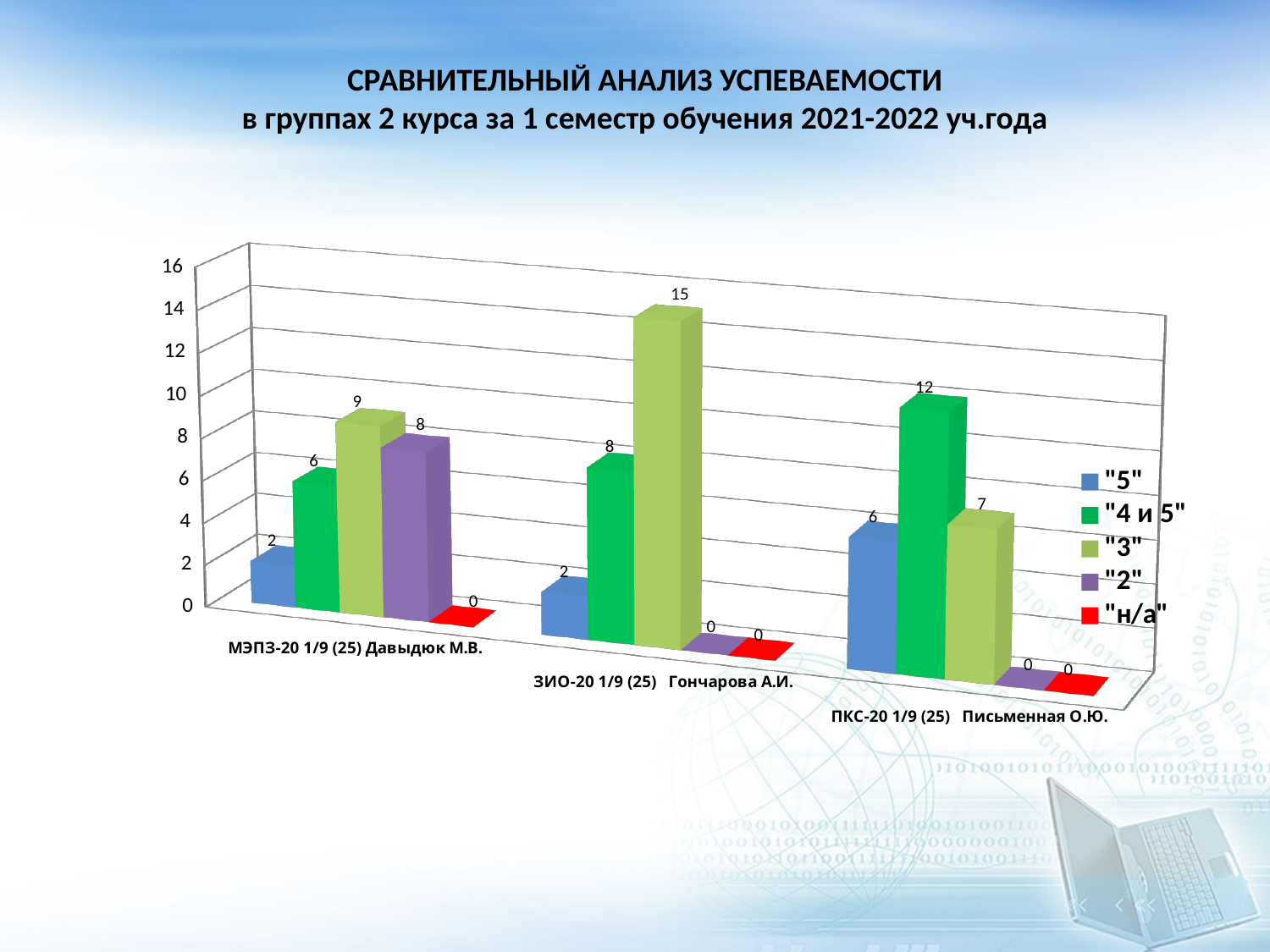
What is the value of the "4 и 5" series for ПКС-20 1/9 (25) Письменная О.Ю.? 12 Which group has the lowest value for the "4 и 5" series? МЭПЗ-20 1/9 (25) Давыдюк М.В. What is the value of the "2" series for МЭПЗ-20 1/9 (25) Давыдюк М.В.? 8 What type of chart is shown on the slide? bar chart Which colour represents the "н/а" series in the legend? red What is the difference between the "3" value for ЗИО-20 1/9 (25) and the "3" value for МЭПЗ-20 1/9 (25)? 6 Which is larger: the "5" value for ПКС-20 1/9 (25) or the "5" value for ЗИО-20 1/9 (25)? ПКС-20 1/9 (25) What is the value of the "3" series for ЗИО-20 1/9 (25) Гончарова А.И.? 15 What is the total of all five series for ПКС-20 1/9 (25) Письменная О.Ю.? 25 How many groups (categories) are shown on the x axis? 3 How many series does the legend list? 5 Which group has the highest value for the "3" series? ЗИО-20 1/9 (25) Гончарова А.И.